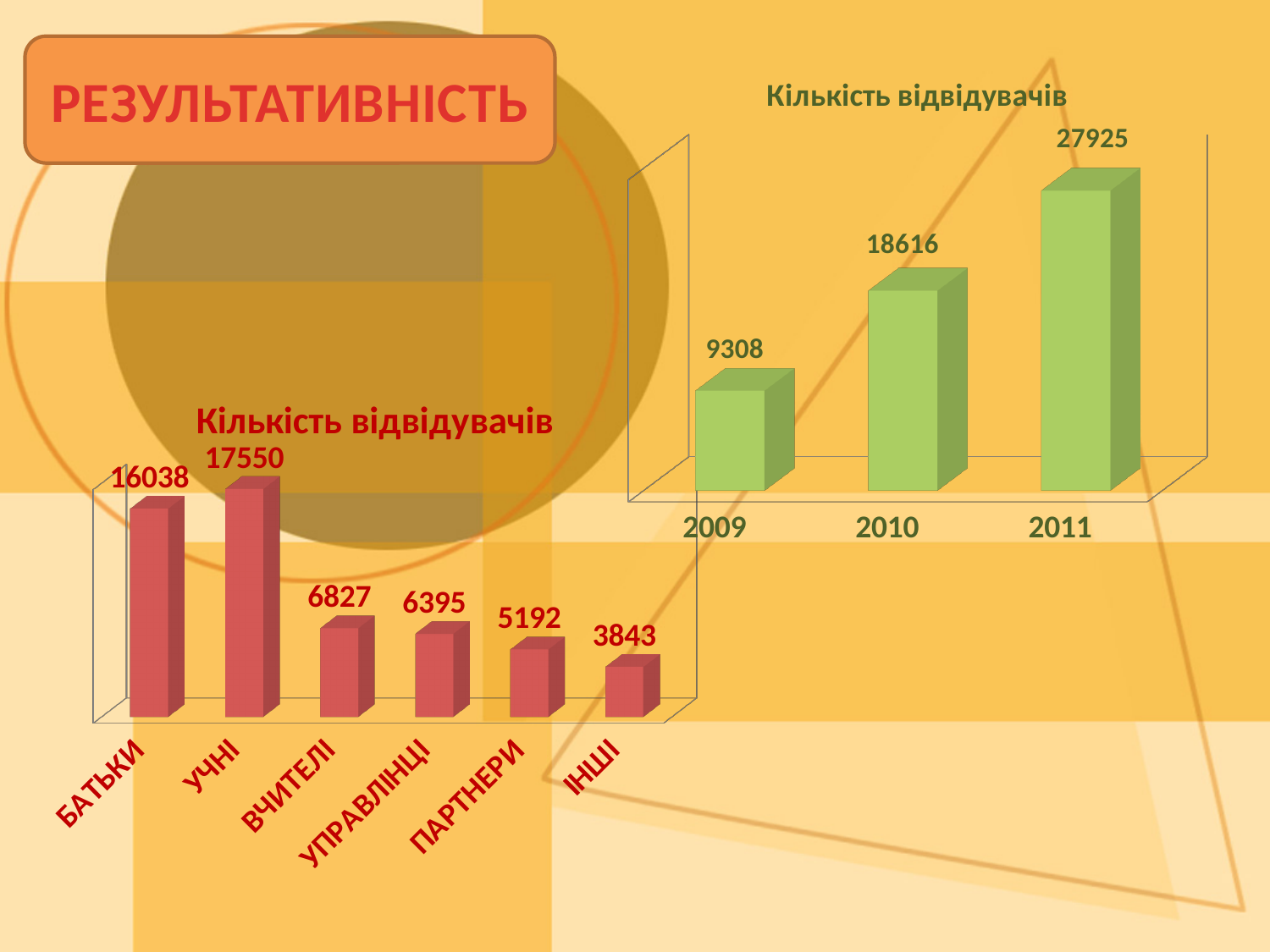
In the red chart on the left, what is the value for ПАРТНЕРИ? 5192 In the green chart on the right, what is the difference between the values for 2011 and 2009? 18617 In the red chart on the left, which is larger, the value for ВЧИТЕЛІ or the value for УПРАВЛІНЦІ? ВЧИТЕЛІ In the red chart on the left, what is the difference between the values for УЧНІ and БАТЬКИ? 1512 What type of chart is the green chart on the right? bar chart In the red chart on the left, which category has the highest value? УЧНІ In the red chart on the left, what is the value for УЧНІ? 17550 In the red chart on the left, which category has the lowest value? ІНШІ In the green chart on the right, what is the value for 2009? 9308 In the green chart on the right, what is the value for 2011? 27925 How many categories are shown in the red chart on the left? 6 In the green chart on the right, do the values rise or fall from 2009 to 2011? rise